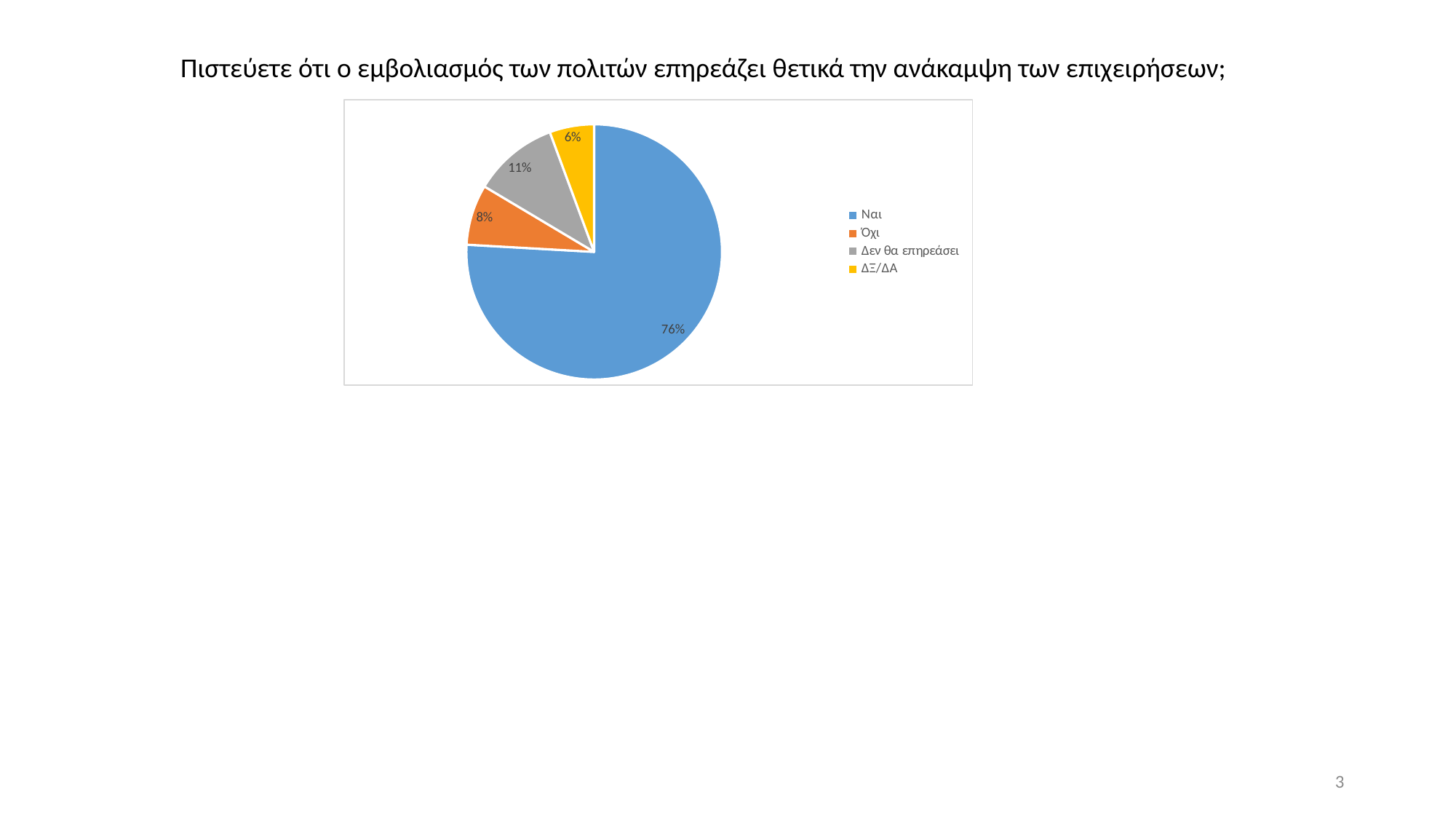
What is the difference in percentage points between Δεν θα επηρεάσει and Όχι? 3 What is the difference in percentage points between Ναι and Δεν θα επηρεάσει? 65 Which category has the largest slice of the pie? Ναι Which category has the smallest slice of the pie? ΔΞ/ΔΑ What colour is the slice for ΔΞ/ΔΑ? yellow What share of the pie does Όχι have? 8% What share of the pie does ΔΞ/ΔΑ have? 6% How many categories does the pie chart have? 4 What kind of chart is shown on the slide? pie chart What share of the pie does Δεν θα επηρεάσει have? 11% Which is larger, the slice for Όχι or the slice for Δεν θα επηρεάσει? Δεν θα επηρεάσει